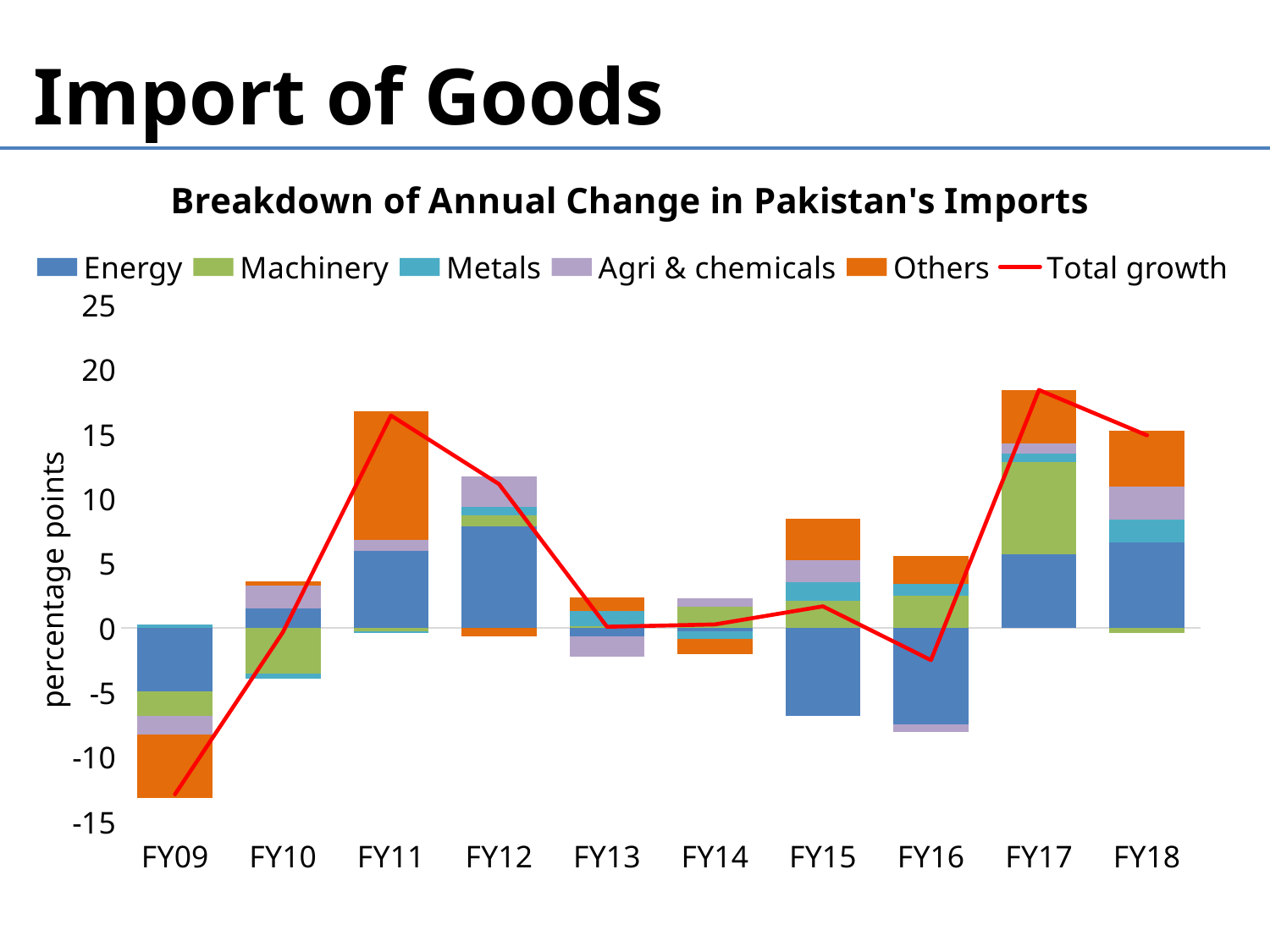
What is the title of the chart? Breakdown of Annual Change in Pakistan's Imports Is the Total growth value for FY09 greater or less than -10? less How many series does the legend list? 6 Does Total growth rise or fall from FY11 to FY13? fall How many fiscal years are shown on the x axis? 10 Is the Total growth value for FY16 greater or less than 0? less What kind of chart is shown on the slide? Stacked bar chart with a line Which has the larger Total growth, FY11 or FY17? FY17 In which fiscal year is Total growth highest? FY17 What is the label on the vertical axis? percentage points Is the Total growth value for FY11 greater or less than 15? greater In which fiscal year is Total growth lowest? FY09